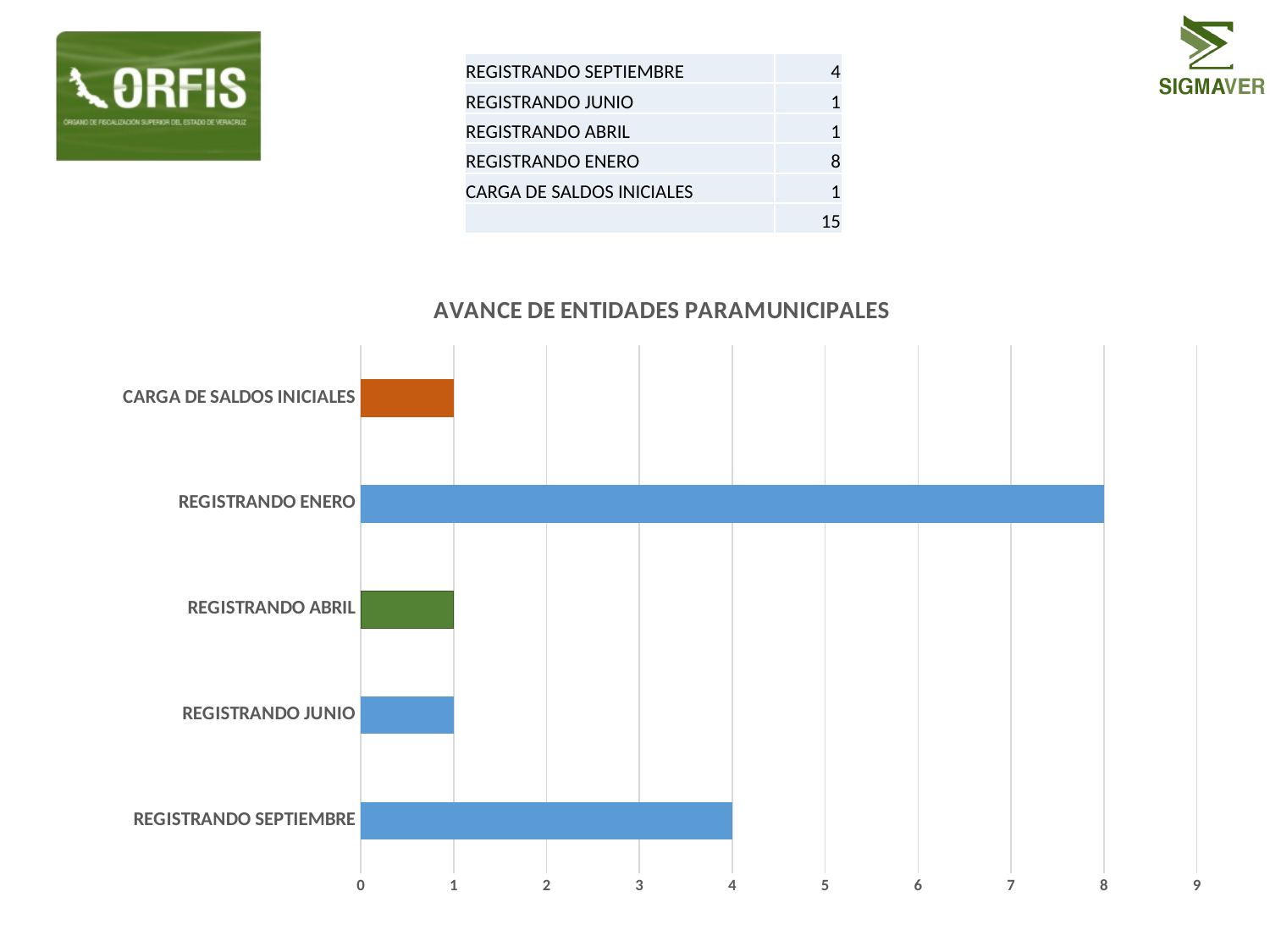
What is the value for REGISTRANDO SEPTIEMBRE? 4 Is the value for REGISTRANDO ENERO greater or less than 5? greater What colour is the bar for CARGA DE SALDOS INICIALES? orange What type of chart is shown on the slide? bar chart How many categories are plotted in the chart? 5 What is the total of all the values shown in the table above the chart? 15 What is the value for CARGA DE SALDOS INICIALES? 1 What is the value for REGISTRANDO ENERO? 8 Which category has the highest value? REGISTRANDO ENERO What is the title of the chart? AVANCE DE ENTIDADES PARAMUNICIPALES What is the difference between the values for REGISTRANDO ENERO and REGISTRANDO SEPTIEMBRE? 4 Which is larger, the value for REGISTRANDO SEPTIEMBRE or the value for REGISTRANDO JUNIO? REGISTRANDO SEPTIEMBRE